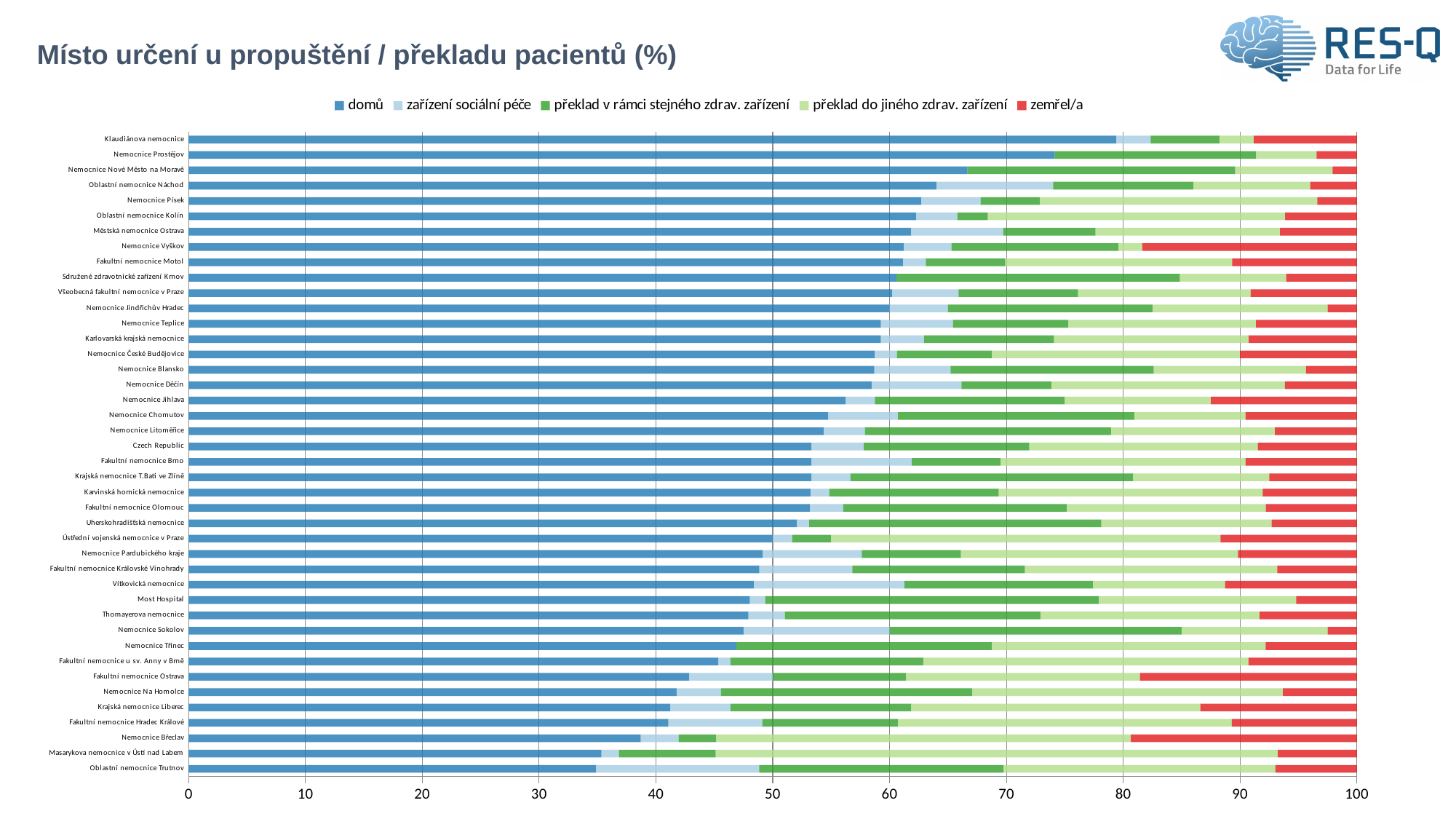
Is the 'domů' value for Klaudiánova nemocnice greater or less than 70? greater How many hospitals/categories are plotted on the chart? 42 Is the 'domů' value for Fakultní nemocnice Ostrava greater or less than 50? less Which series is shown in red in the legend? zemřel/a Is the 'domů' value for Oblastní nemocnice Trutnov greater or less than 40? less Which has a larger 'domů' value, Klaudiánova nemocnice or Oblastní nemocnice Trutnov? Klaudiánova nemocnice Which has a larger 'domů' value, Nemocnice Prostějov or Nemocnice Břeclav? Nemocnice Prostějov How many series does the legend list? 5 Do the 'domů' values rise or fall going from the top category to the bottom category? fall What is the title of the chart? Místo určení u propuštění / překladu pacientů (%) What kind of chart is shown on the slide? Stacked bar chart Which category has the highest value for 'domů'? Klaudiánova nemocnice